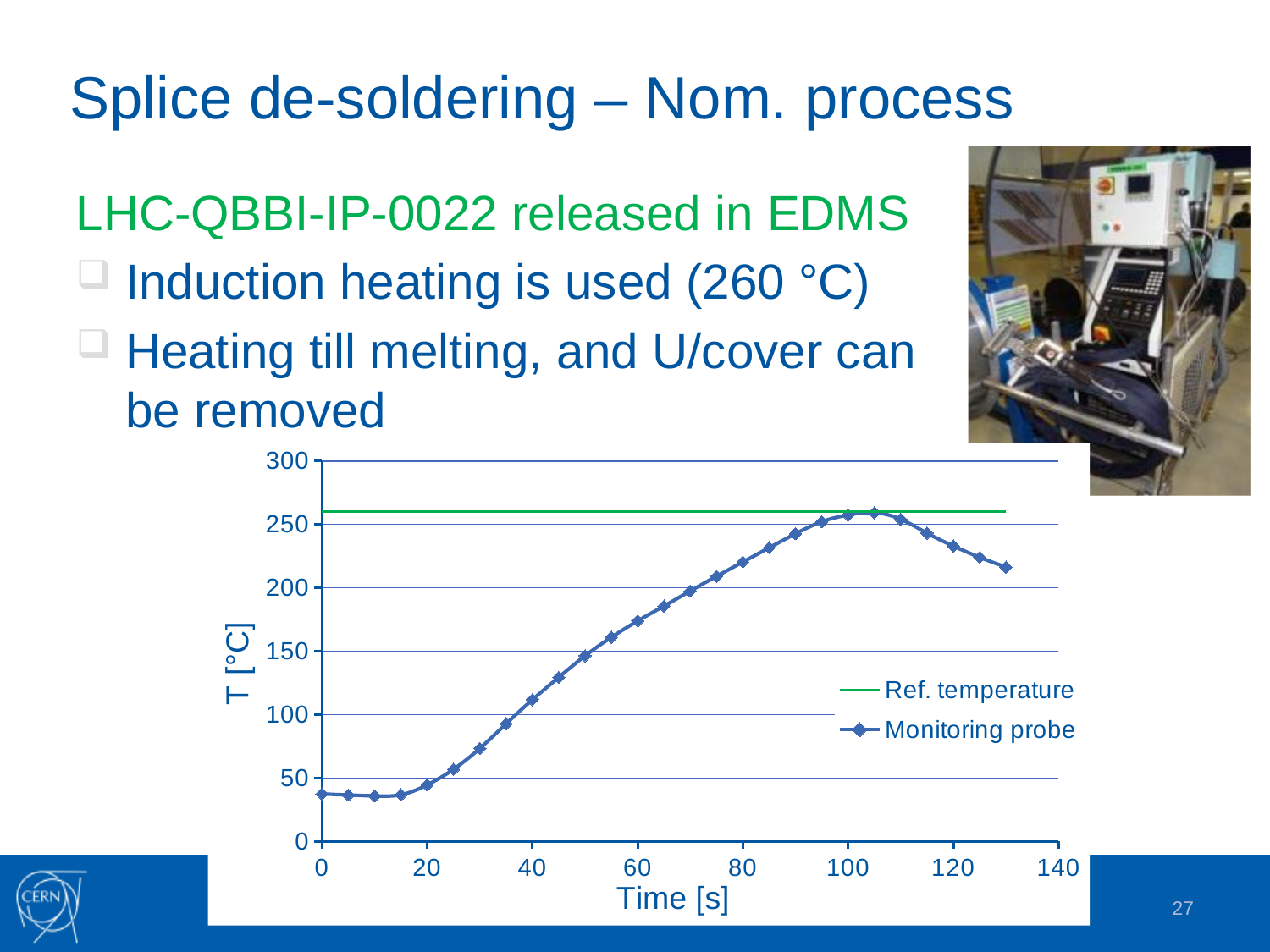
Is the Ref. temperature line greater or less than 250 on the T [°C] axis? greater Is the Monitoring probe value at 40 s greater or less than 100? greater Which is larger for the Monitoring probe: the value at 20 s or the value at 80 s? 80 s What are the two series named in the chart legend? Ref. temperature and Monitoring probe How many series does the chart legend list? 2 Is the Monitoring probe value at 60 s greater or less than 150? greater How does the Monitoring probe temperature change between 20 s and 100 s? it rises What is the label of the x axis of the chart? Time [s] What kind of chart is shown on the slide? line chart How does the Monitoring probe temperature change between 110 s and 130 s? it falls